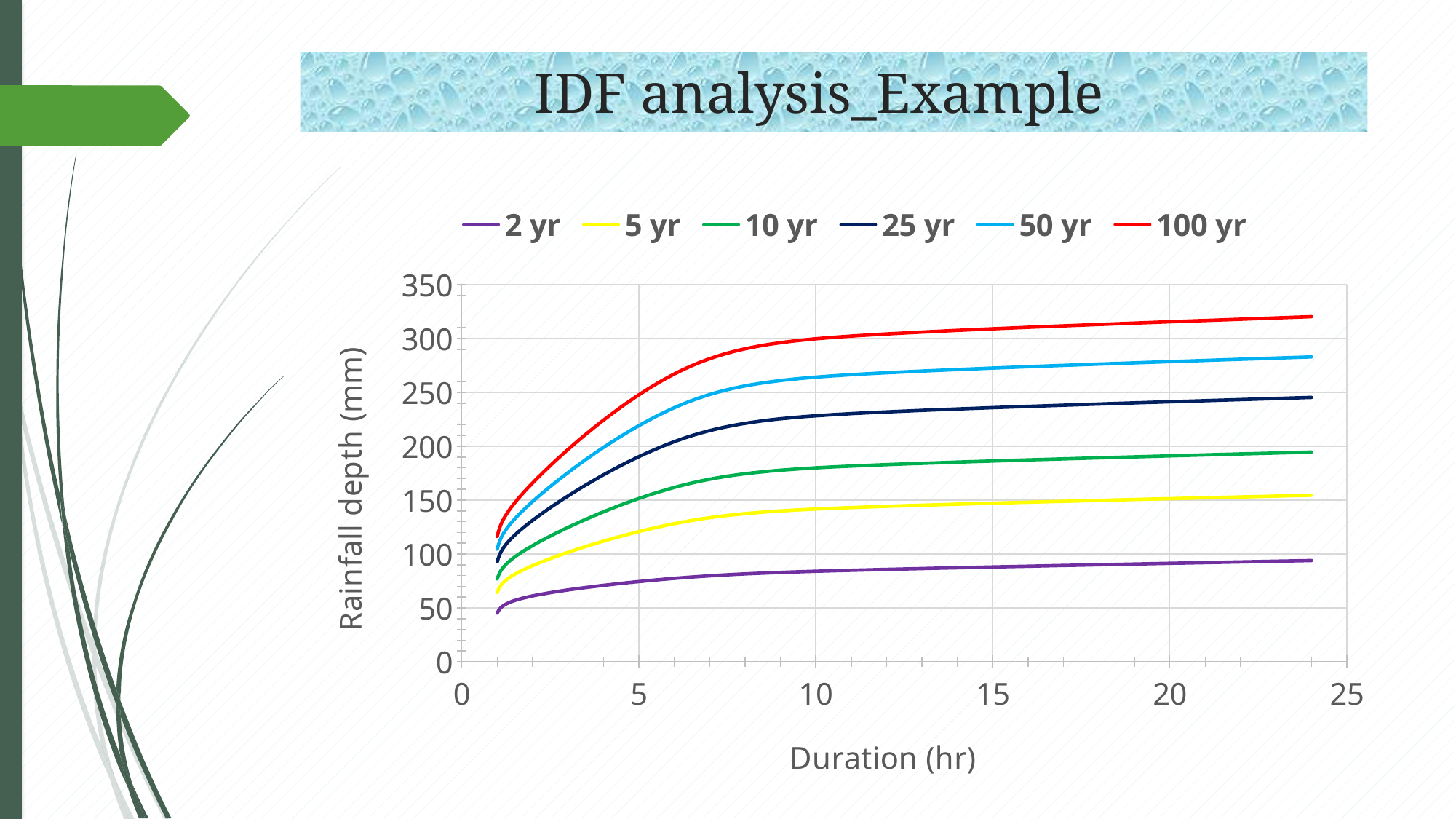
What is the title of the vertical axis? Rainfall depth (mm) What colour is the line for the 25 yr series? dark blue Is the rainfall depth for the 50 yr series at 10 hr greater or less than 250? greater Is the rainfall depth for the 2 yr series at 24 hr greater or less than 100? less Which series has the highest rainfall depth across all durations? 100 yr Is the rainfall depth for the 100 yr series at 24 hr greater or less than 300? greater Which series has the lowest rainfall depth across all durations? 2 yr What kind of chart is shown on the slide? line chart How many series does the legend list? 6 At a duration of 24 hr, which series has the larger rainfall depth, 50 yr or 10 yr? 50 yr Does the rainfall depth for the 100 yr series rise or fall as duration increases? rise